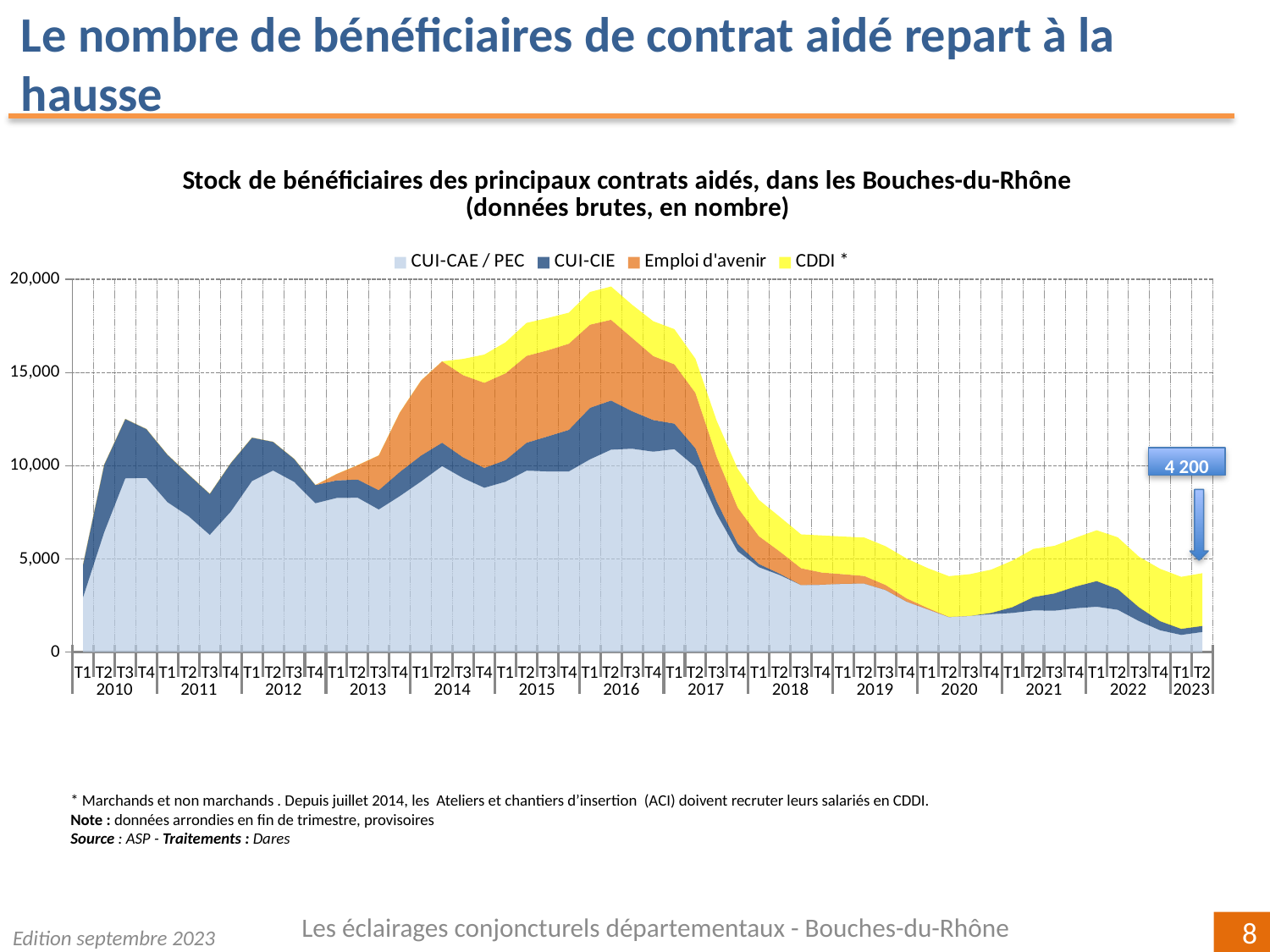
Does the total stock of beneficiaries rise or fall between 2016 and 2020? Fall Which series is shown in yellow in the legend? CDDI * What kind of chart is shown on the slide? Stacked area chart Is the total stock of beneficiaries in T3 2010 greater or less than 10,000? greater Is the total stock of beneficiaries in T2 2016 greater or less than 15,000? greater How many series does the legend list? 4 Which is larger, the total stock of beneficiaries in T2 2016 or in T2 2020? T2 2016 In which year does the total stock of beneficiaries reach its highest level? 2016 What is the title of the chart? Stock de bénéficiaires des principaux contrats aidés, dans les Bouches-du-Rhône (données brutes, en nombre) How many years are labelled on the x axis? 14 What is the total stock of beneficiaries indicated by the data label for T2 2023? 4 200 Is the total stock of beneficiaries in T2 2020 greater or less than 5,000? less